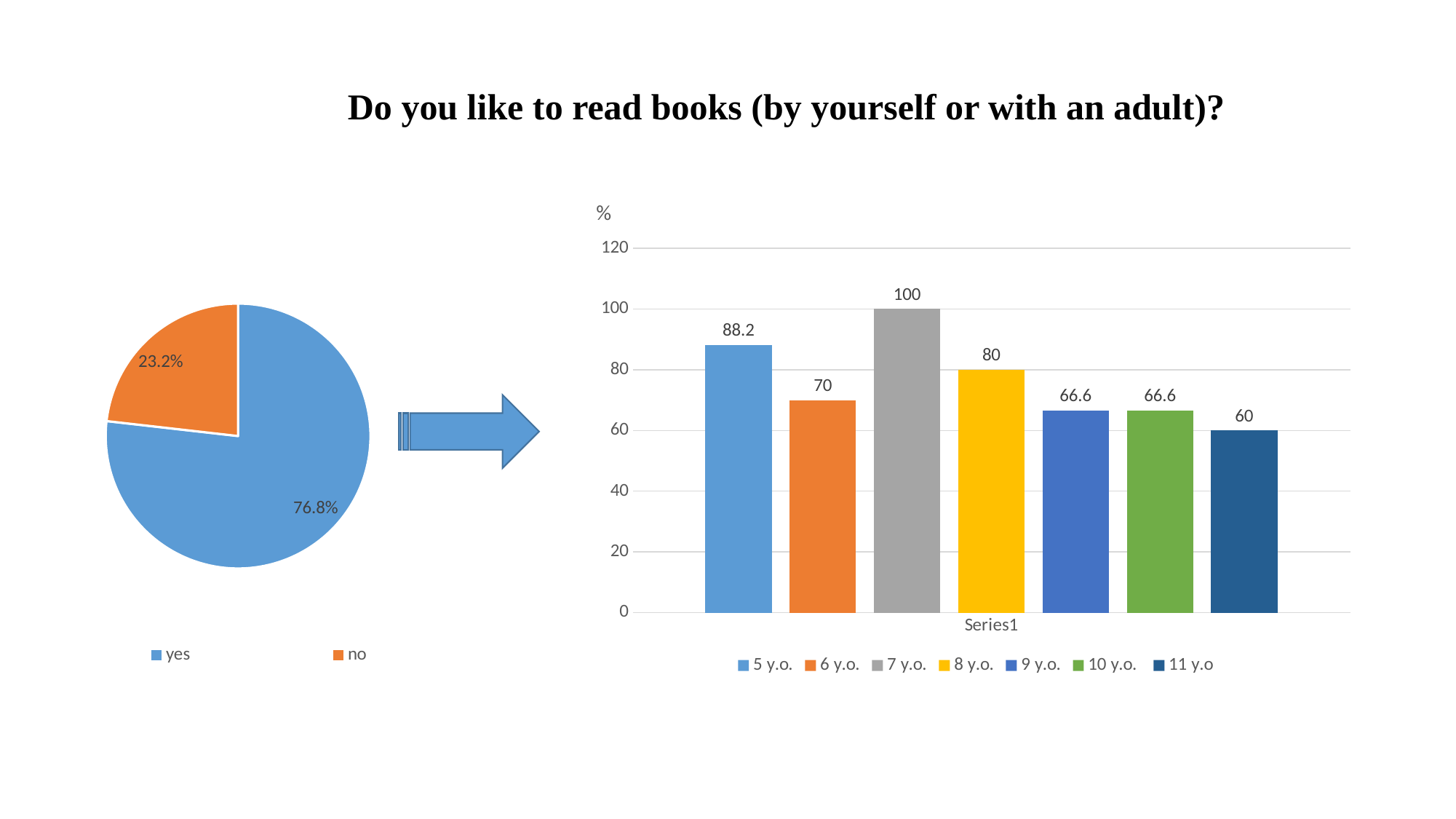
In the pie chart on the left, what share of respondents answered "yes"? 76.8% In the bar chart on the right, what is the value for 5 y.o.? 88.2 What kind of chart is shown on the left of the slide? pie chart In the bar chart on the right, how many series does the legend list? 7 What kind of chart is shown on the right of the slide? bar chart In the bar chart on the right, what is the value for 8 y.o.? 80 In the pie chart on the left, which answer has the larger slice, yes or no? yes In the bar chart on the right, what is the difference between the values for 7 y.o. and 6 y.o.? 30 In the pie chart on the left, what share of respondents answered "no"? 23.2% In the bar chart on the right, is the value for 6 y.o. larger or smaller than the value for 8 y.o.? smaller In the bar chart on the right, which age group has the highest value? 7 y.o. In the bar chart on the right, which age group has the lowest value? 11 y.o